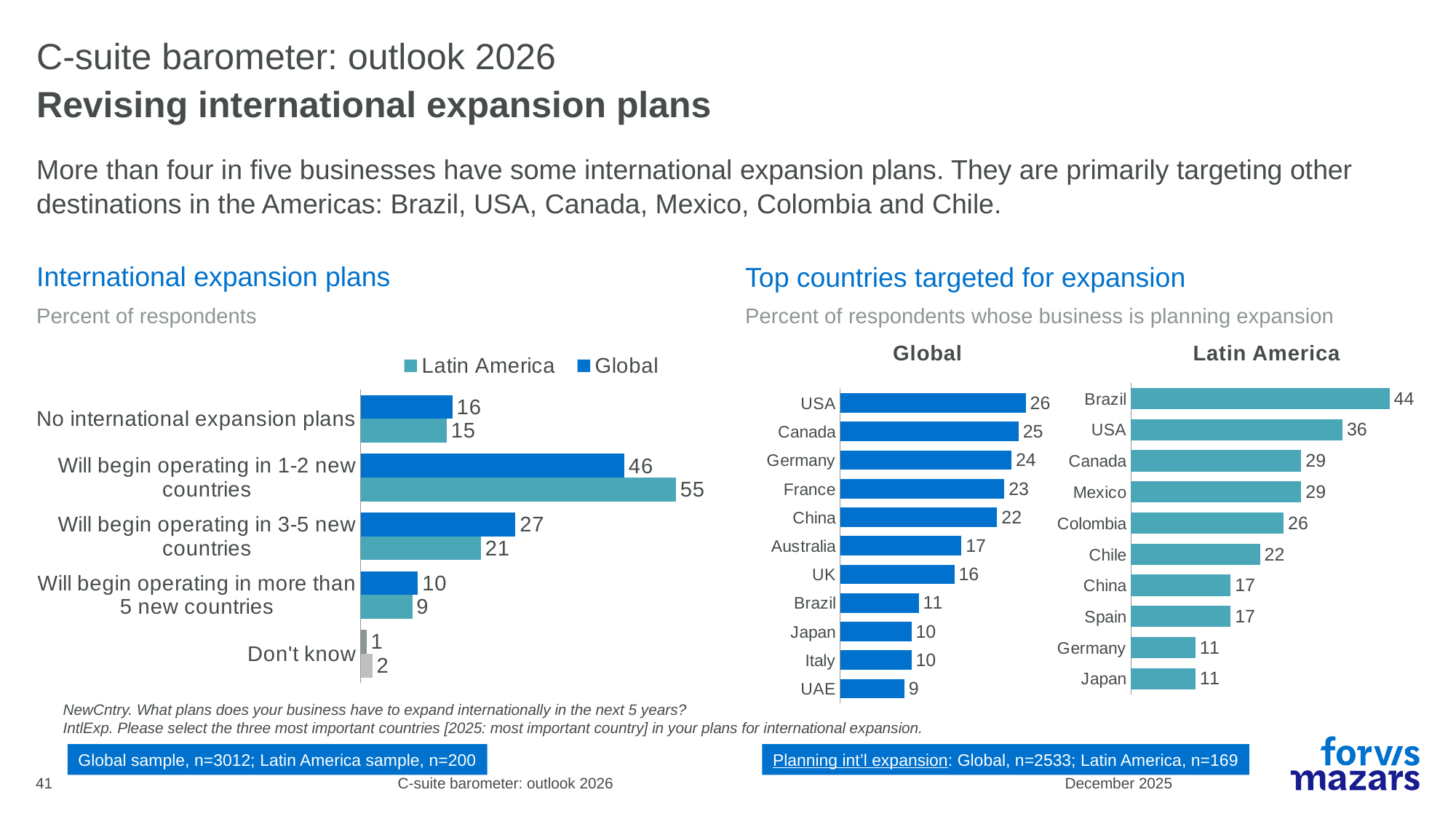
In the 'Top countries targeted for expansion' Global chart, what is the value for Australia? 17 In the 'International expansion plans' chart, which category has the lowest Global value? Don't know What kind of chart is the 'International expansion plans' chart? Bar chart In the 'Top countries targeted for expansion' Latin America chart, which is larger, the value for Colombia or the value for Chile? Colombia In the 'Top countries targeted for expansion' Global chart, which country has the highest value? USA In the 'International expansion plans' chart, what is the difference between the Global and Latin America values for 'Will begin operating in 1-2 new countries'? 9 In the 'International expansion plans' chart, what is the Latin America value for 'Will begin operating in 1-2 new countries'? 55 In the 'Top countries targeted for expansion' Global chart, how many countries are shown? 11 In the 'Top countries targeted for expansion' Latin America chart, what is the value for Brazil? 44 In the 'Top countries targeted for expansion' Latin America chart, what is the difference between Brazil and USA? 8 In the 'International expansion plans' chart, what is the Global value for 'Will begin operating in 3-5 new countries'? 27 In the 'International expansion plans' chart, how many series does the legend list? 2